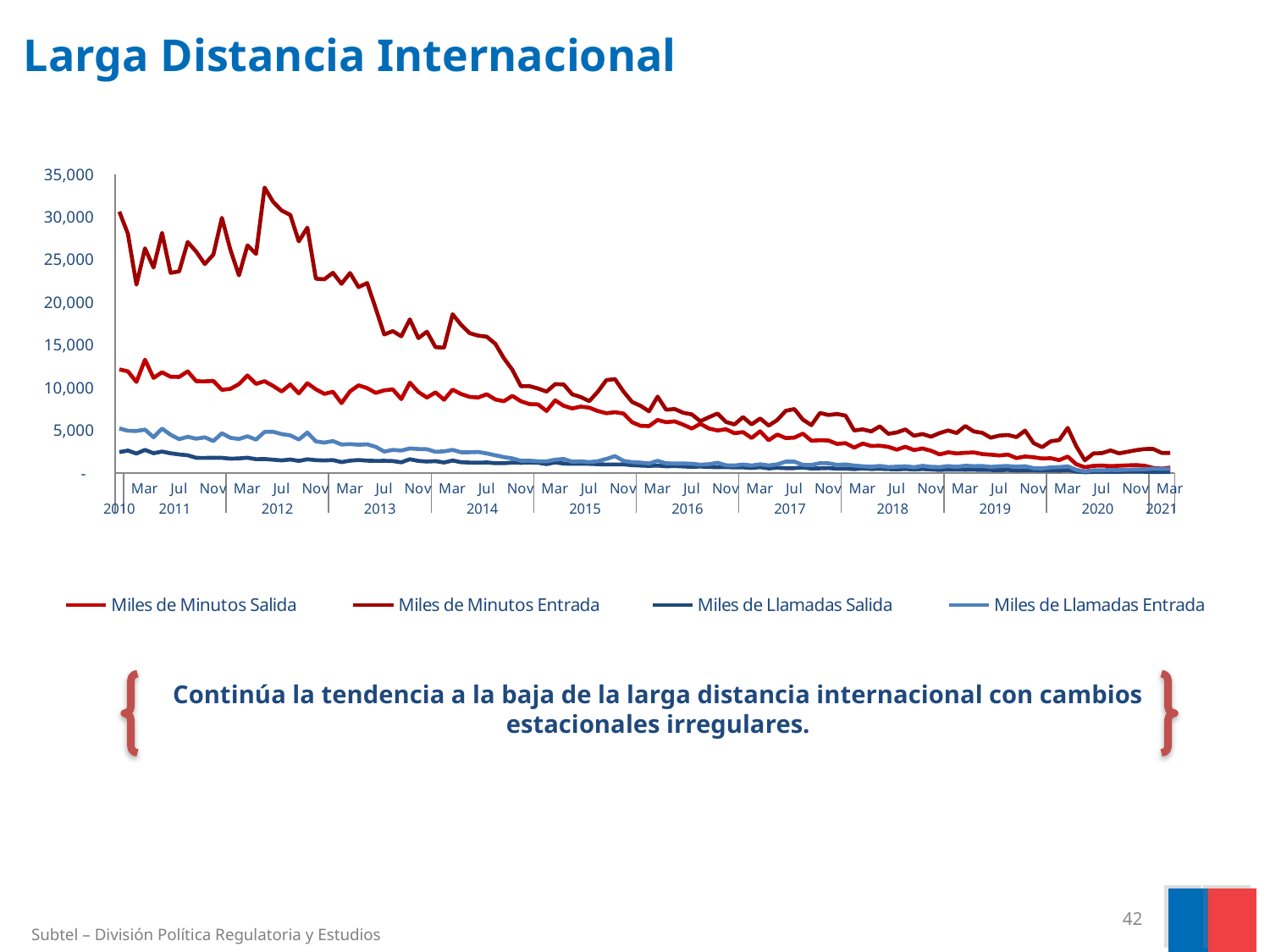
What is the title of the slide containing the chart? Larga Distancia Internacional Do the values of the top line generally rise or fall from 2010 to 2021? fall What kind of chart is shown on the slide? line chart What is the highest tick value shown on the vertical axis? 35,000 Which series is listed last in the chart legend? Miles de Llamadas Entrada Is the value for Miles de Minutos Salida in Mar 2021 greater or less than 10,000? less Is the highest value plotted in 2010 greater or less than 25,000? greater Is the value for Miles de Minutos Entrada in Mar 2021 greater or less than 5,000? less How many series does the legend list? 4